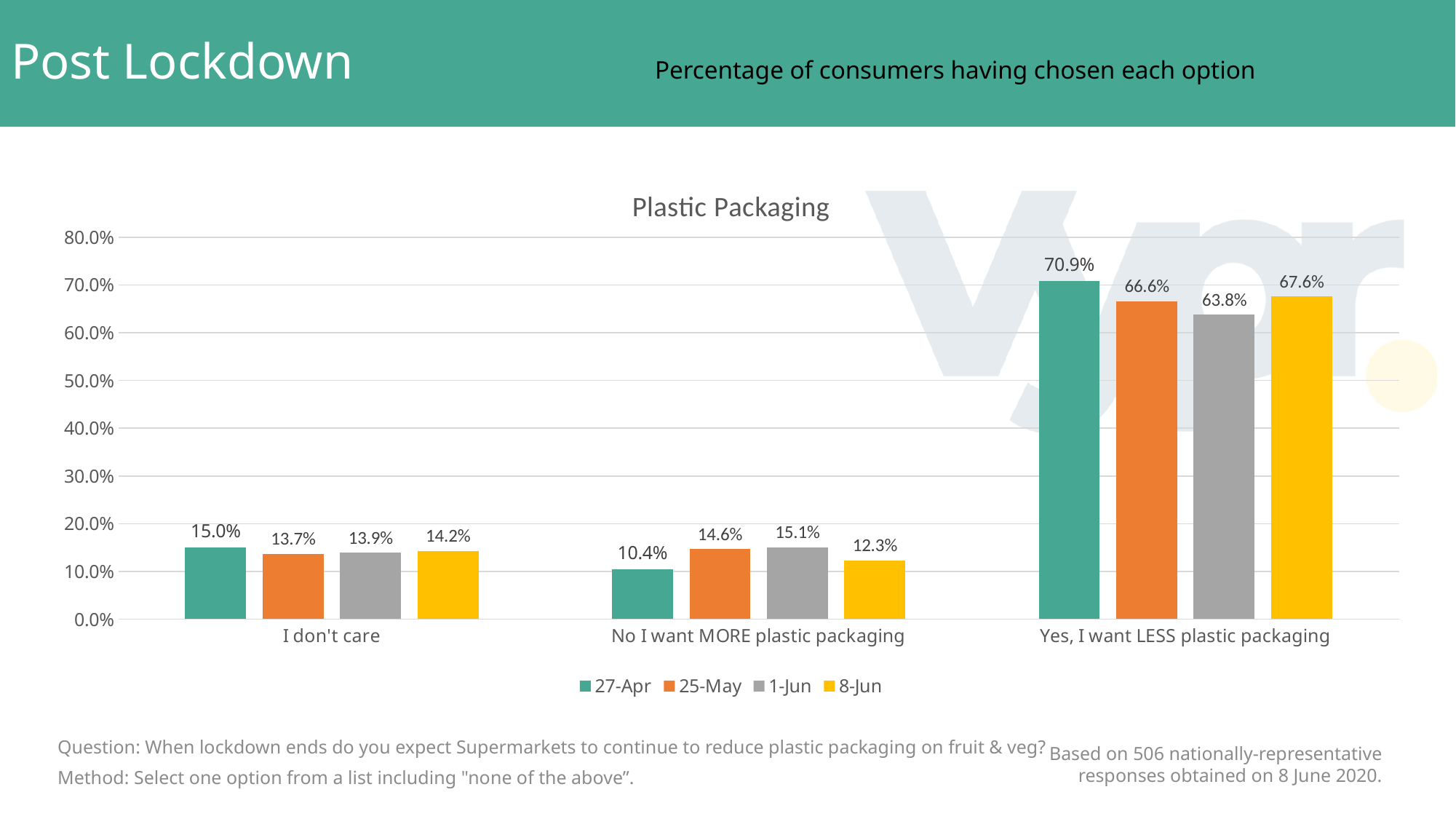
What is the value for 25-May in the "I don't care" category? 13.7% How many categories are shown on the x axis? 3 What is the value for 8-Jun in the "No I want MORE plastic packaging" category? 12.3% Which is larger in the "No I want MORE plastic packaging" category: 25-May or 8-Jun? 25-May What is the title of the chart? Plastic Packaging Which series has the lowest value in the "No I want MORE plastic packaging" category? 27-Apr What is the difference between the 27-Apr and 1-Jun values in the "Yes, I want LESS plastic packaging" category? 7.1% What is the value for 27-Apr in the "Yes, I want LESS plastic packaging" category? 70.9% Is the 8-Jun value for "Yes, I want LESS plastic packaging" greater or less than 60.0%? greater Which series has the highest value in the "Yes, I want LESS plastic packaging" category? 27-Apr How many series does the legend list? 4 What kind of chart is shown on the slide? Bar chart